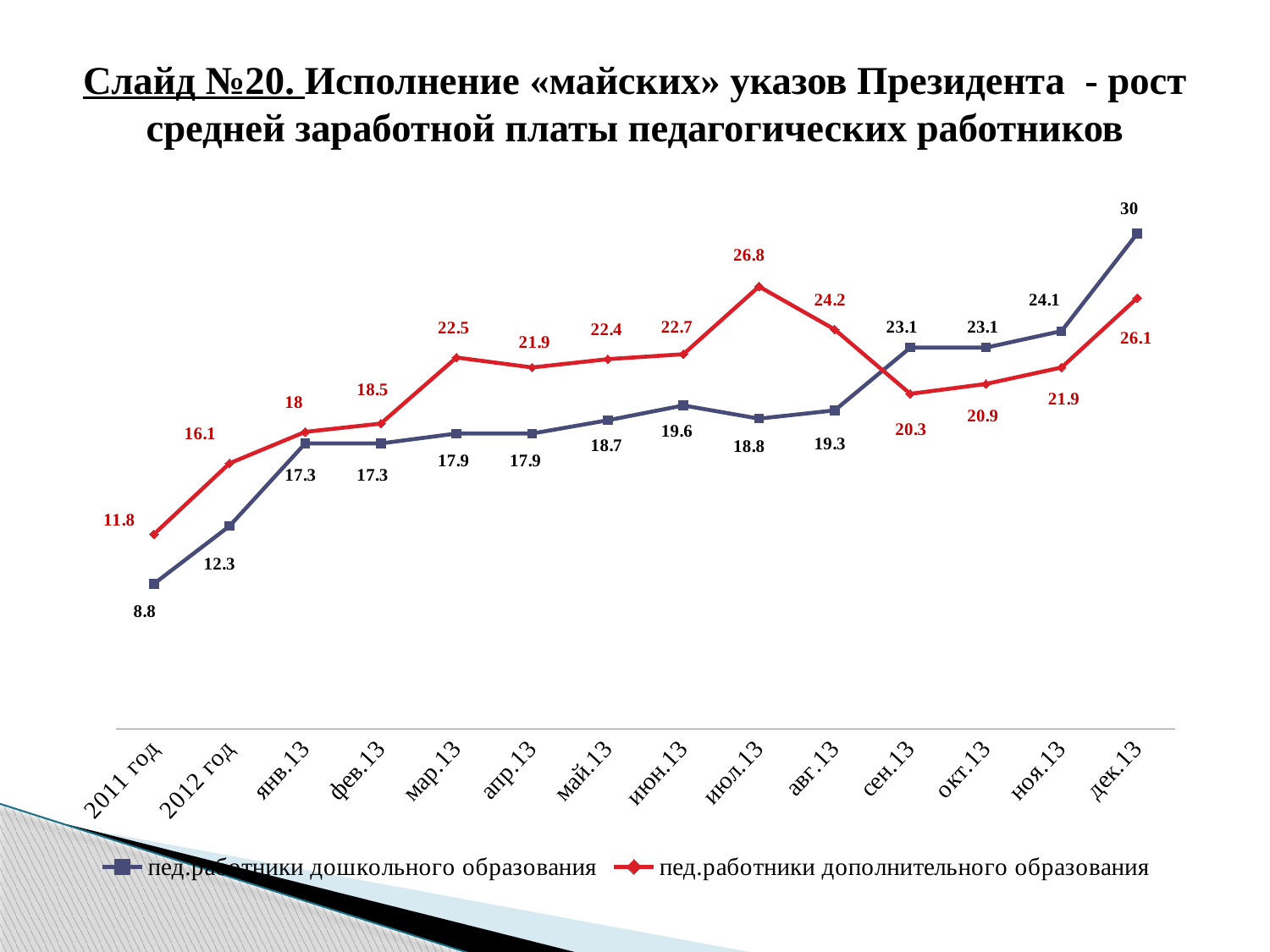
What is the value for пед.работники дошкольного образования in 2011 год? 8.8 How many series does the legend list? 2 Does the value for пед.работники дошкольного образования rise or fall from 2011 год to янв.13? rise In which category is the value for пед.работники дошкольного образования lowest? 2011 год Which colour is used for the пед.работники дополнительного образования series? red What is the difference between the two series in дек.13? 3.9 In which category does пед.работники дополнительного образования reach its highest value? июл.13 Which series has the larger value in сен.13? пед.работники дошкольного образования What type of chart is shown on the slide? line chart How many categories are shown along the x axis? 14 What is the value for пед.работники дошкольного образования in дек.13? 30 What is the value for пед.работники дополнительного образования in июл.13? 26.8